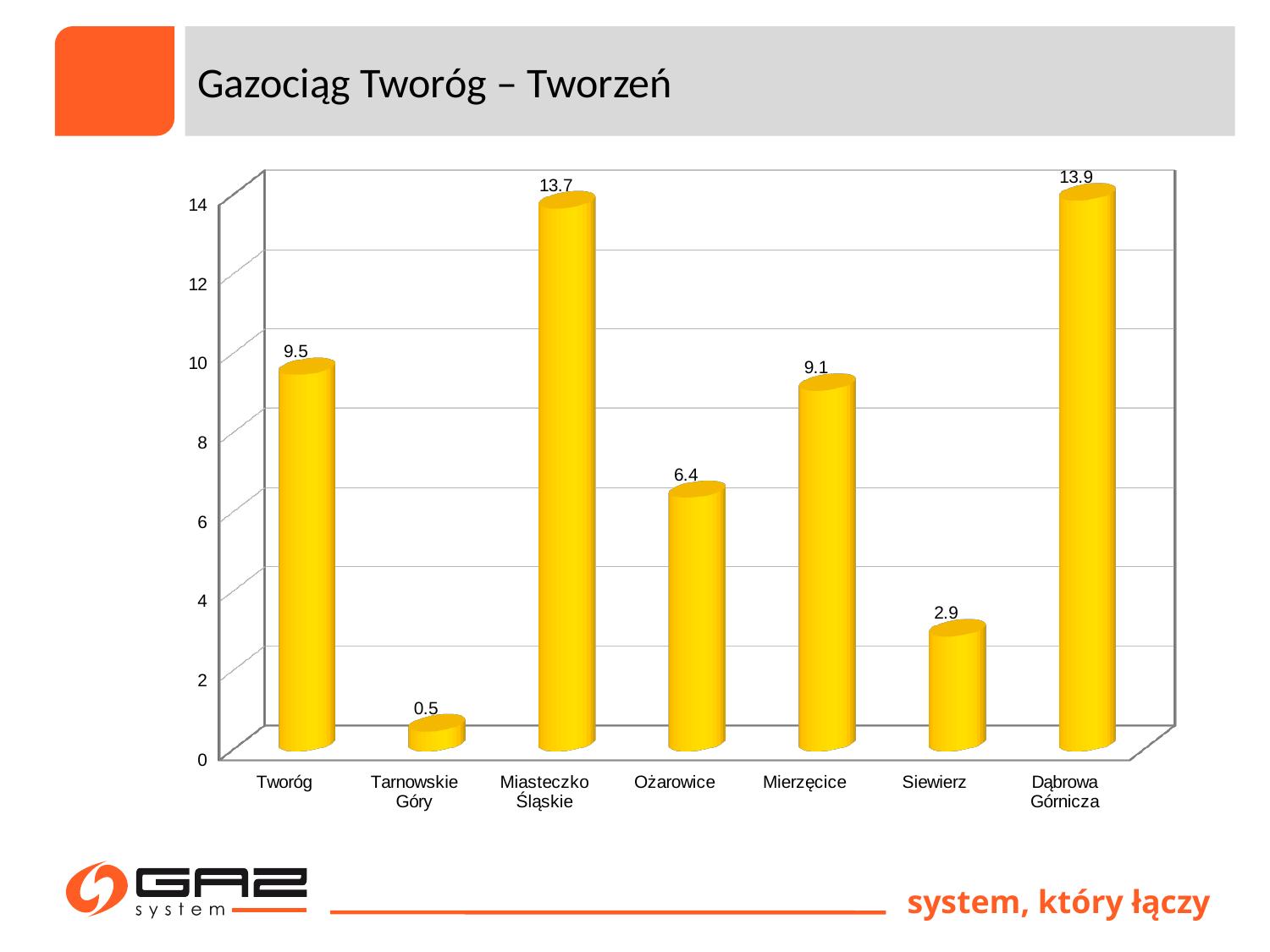
What is the value for Tworóg? 9.5 Is the value for Ożarowice greater or less than 8? less How many categories are shown on the x axis? 7 Which category has the highest value? Dąbrowa Górnicza What is the difference between the values for Dąbrowa Górnicza and Miasteczko Śląskie? 0.2 What is the title of the slide containing the chart? Gazociąg Tworóg – Tworzeń What is the difference between the values for Mierzęcice and Ożarowice? 2.7 What kind of chart is shown on the slide? bar chart Which category has the lowest value? Tarnowskie Góry What is the value for Miasteczko Śląskie? 13.7 What is the value for Siewierz? 2.9 Which is larger, the value for Tworóg or the value for Mierzęcice? Tworóg